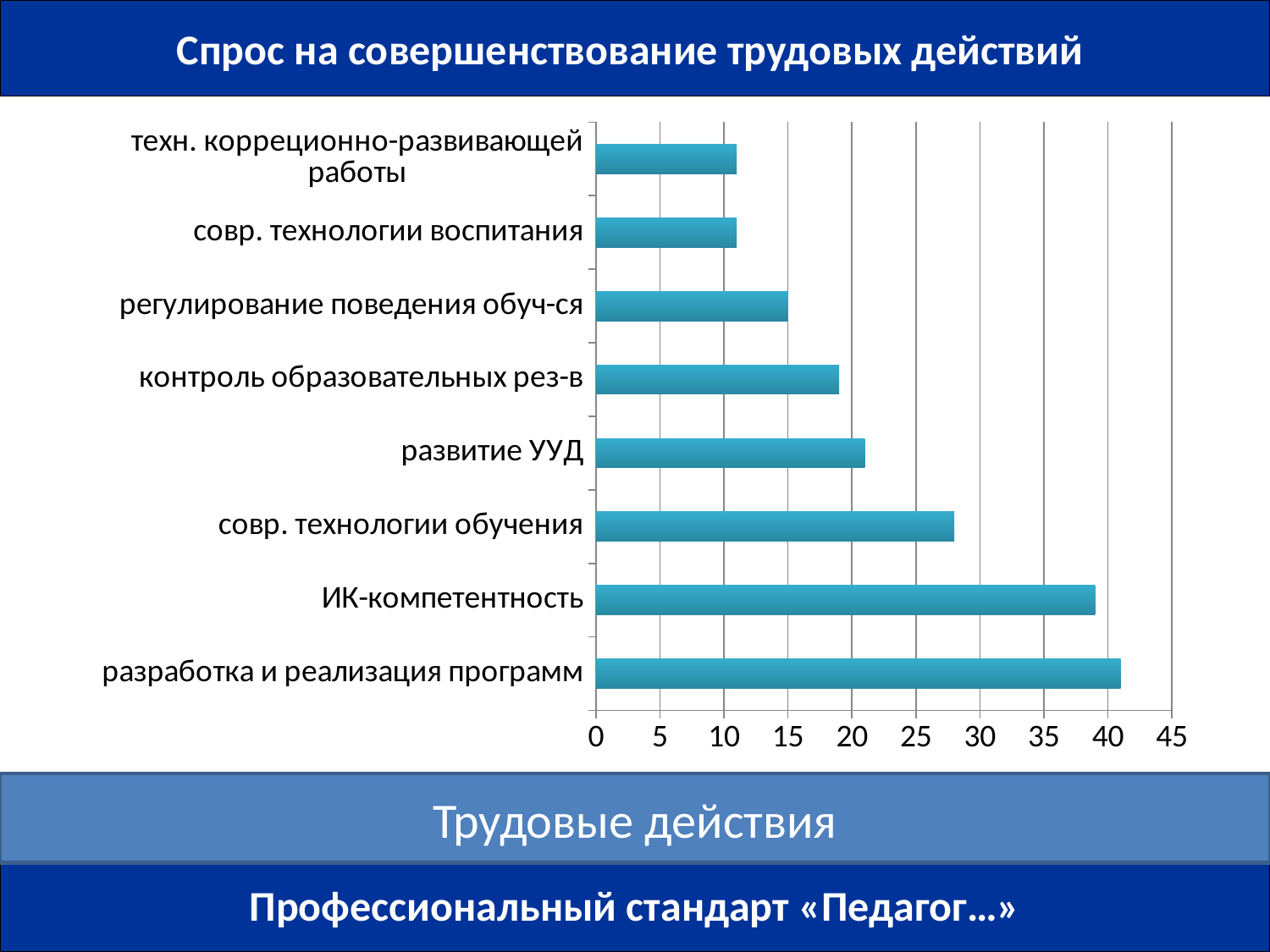
Is the value for совр. технологии обучения greater or less than 25? greater Is the value for контроль образовательных рез-в greater or less than 20? less How many categories are plotted in the chart? 8 Which is larger: the value for ИК-компетентность or the value for совр. технологии обучения? ИК-компетентность Is the value for совр. технологии воспитания greater or less than 15? less Which is larger: the value for контроль образовательных рез-в or the value for регулирование поведения обуч-ся? контроль образовательных рез-в What is the highest value shown on the horizontal axis? 45 What kind of chart is shown on the slide? bar chart Which category has the highest value in the chart? разработка и реализация программ What is the title of the chart? Спрос на совершенствование трудовых действий